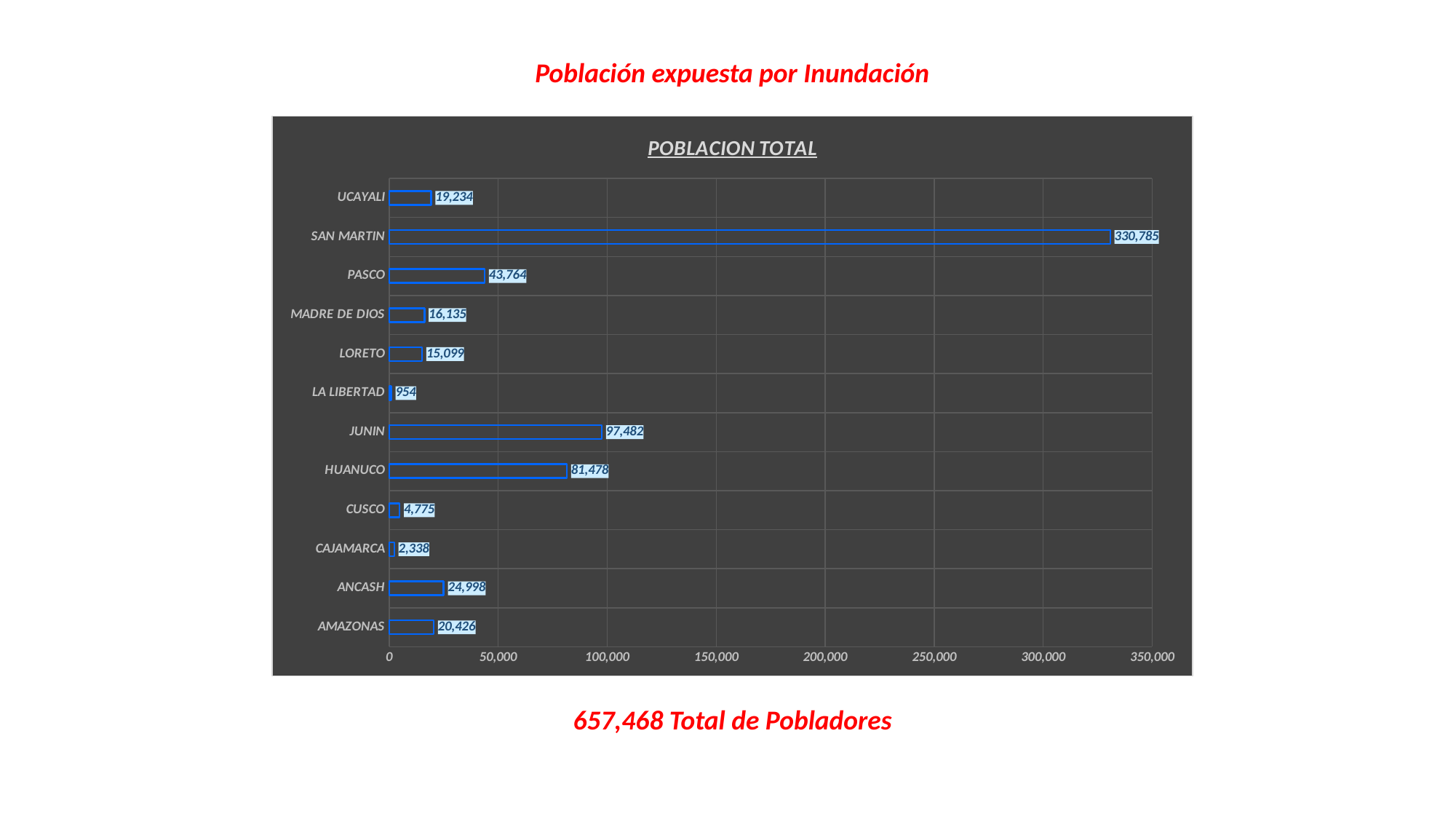
Which category has the lowest value? LA LIBERTAD What is the value for SAN MARTIN? 330,785 What is the difference between the values for JUNIN and HUANUCO? 16,004 What is the title of the chart? POBLACION TOTAL Which category has the highest value? SAN MARTIN What is the value for LA LIBERTAD? 954 What is the value for AMAZONAS? 20,426 Which is larger, the value for PASCO or the value for ANCASH? PASCO Is the value for HUANUCO greater or less than 100,000? less What kind of chart is this? bar chart What is the value for JUNIN? 97,482 How many categories are shown on the chart? 12